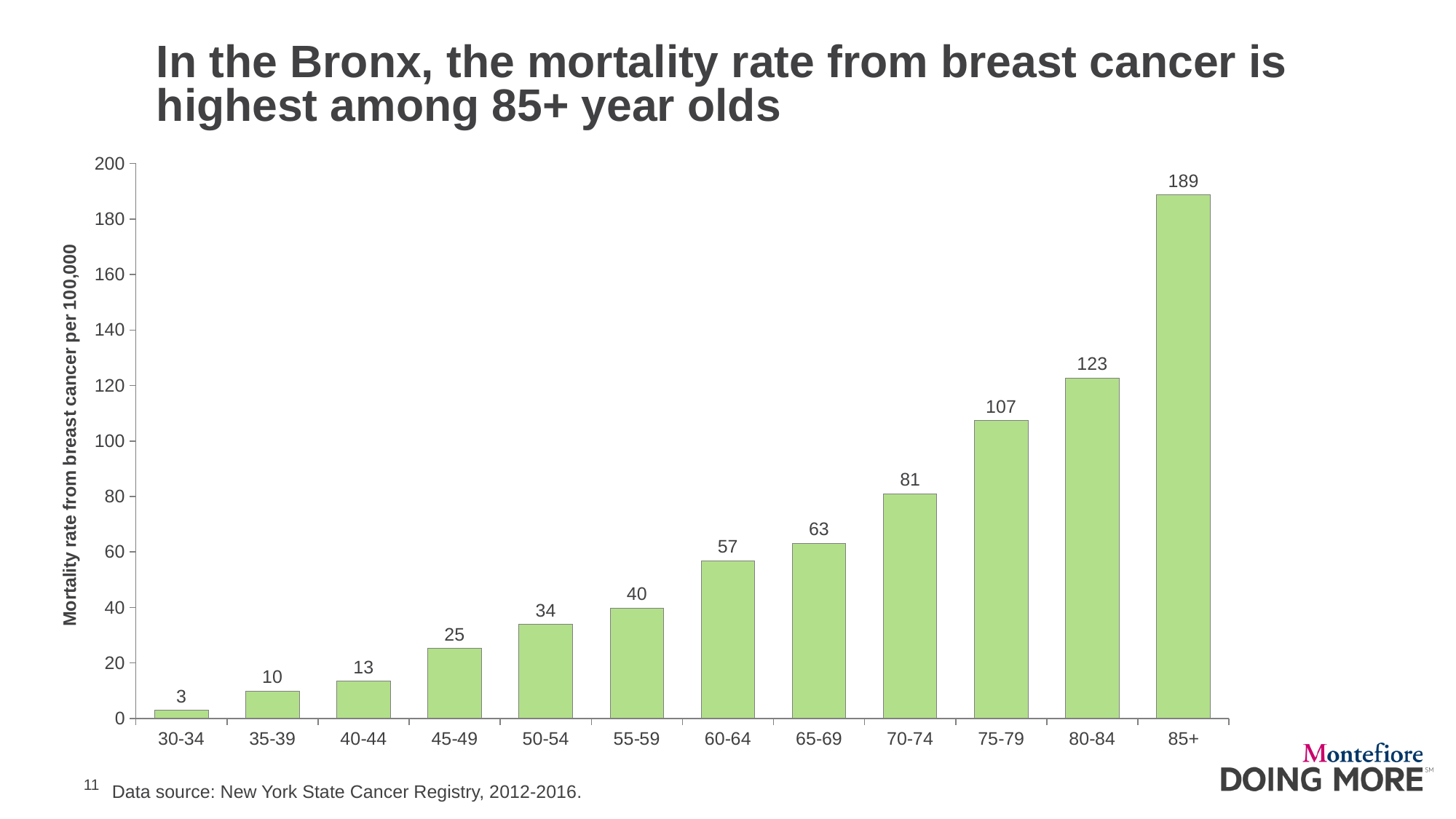
How many age groups are shown on the x axis? 12 What is the difference in mortality rate between the 85+ and 80-84 age groups? 66 Which age group has a higher mortality rate, 55-59 or 65-69? 65-69 What is the mortality rate from breast cancer per 100,000 for the 85+ age group? 189 What is the difference in mortality rate between the 75-79 and 70-74 age groups? 26 What kind of chart is shown on the slide? Bar chart Do the mortality rates rise or fall as age increases along the x axis? Rise Which age group has the lowest mortality rate from breast cancer? 30-34 Is the mortality rate for the 80-84 age group greater or less than 100? greater What is the mortality rate from breast cancer per 100,000 for the 45-49 age group? 25 Which age group has the highest mortality rate from breast cancer? 85+ What is the mortality rate from breast cancer per 100,000 for the 60-64 age group? 57